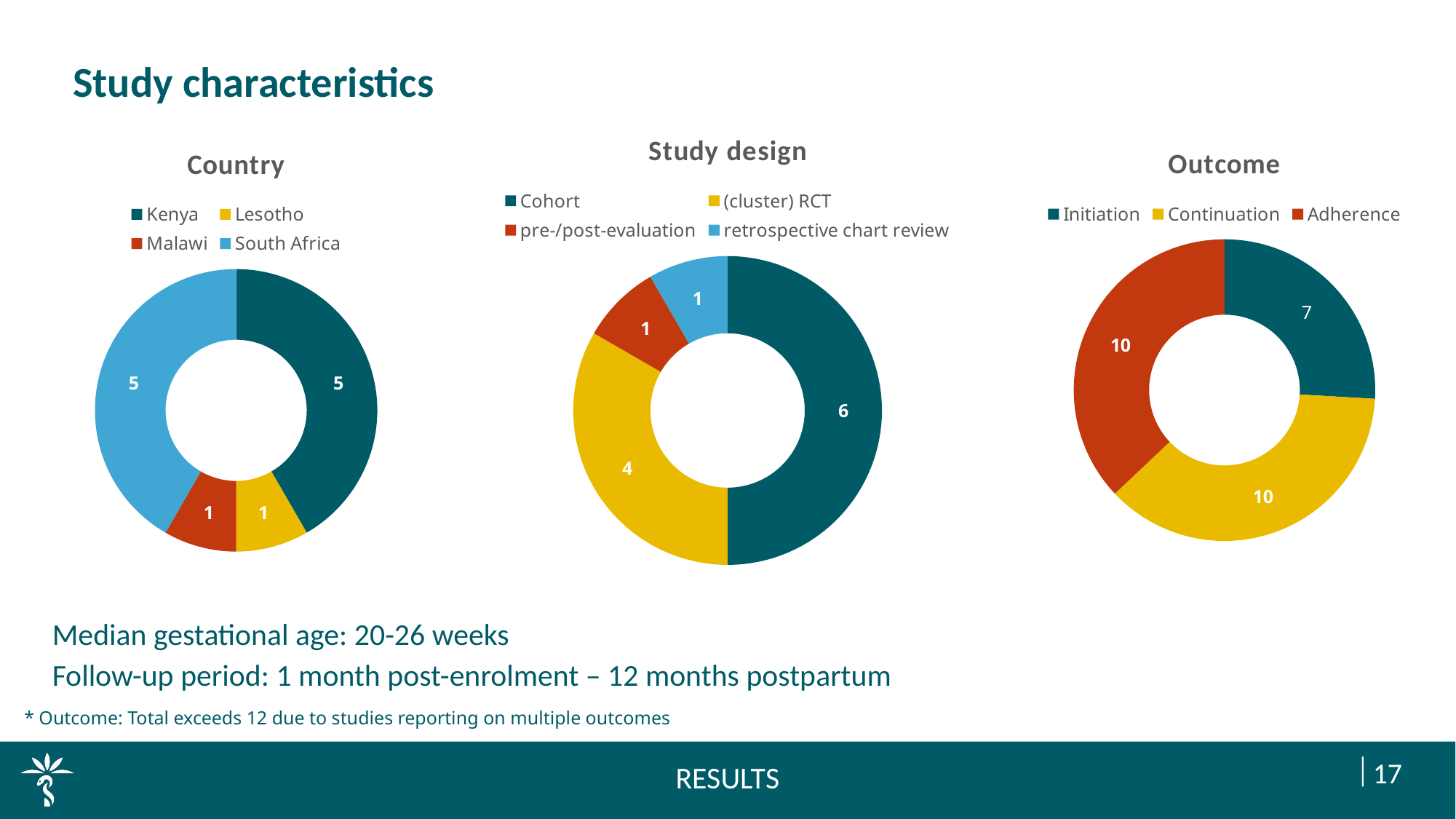
In the Study design chart, what is the difference between the Cohort and (cluster) RCT counts? 2 How many categories does the Study design chart's legend list? 4 In the Country chart, how many studies are from Malawi? 1 In the Country chart, how many studies are from Kenya? 5 In the Study design chart, how many studies are cohort studies? 6 In the Country chart, which is larger: the count for South Africa or the count for Lesotho? South Africa In the Outcome chart, what share of the total do the Continuation studies represent? 10 of 27 In the Outcome chart, which outcome has the lowest count? Initiation In the Study design chart, which study design has the highest count? Cohort In the Outcome chart, how many studies report on Initiation? 7 What kind of chart is the Outcome chart? Doughnut chart In the Study design chart, how many studies are (cluster) RCTs? 4